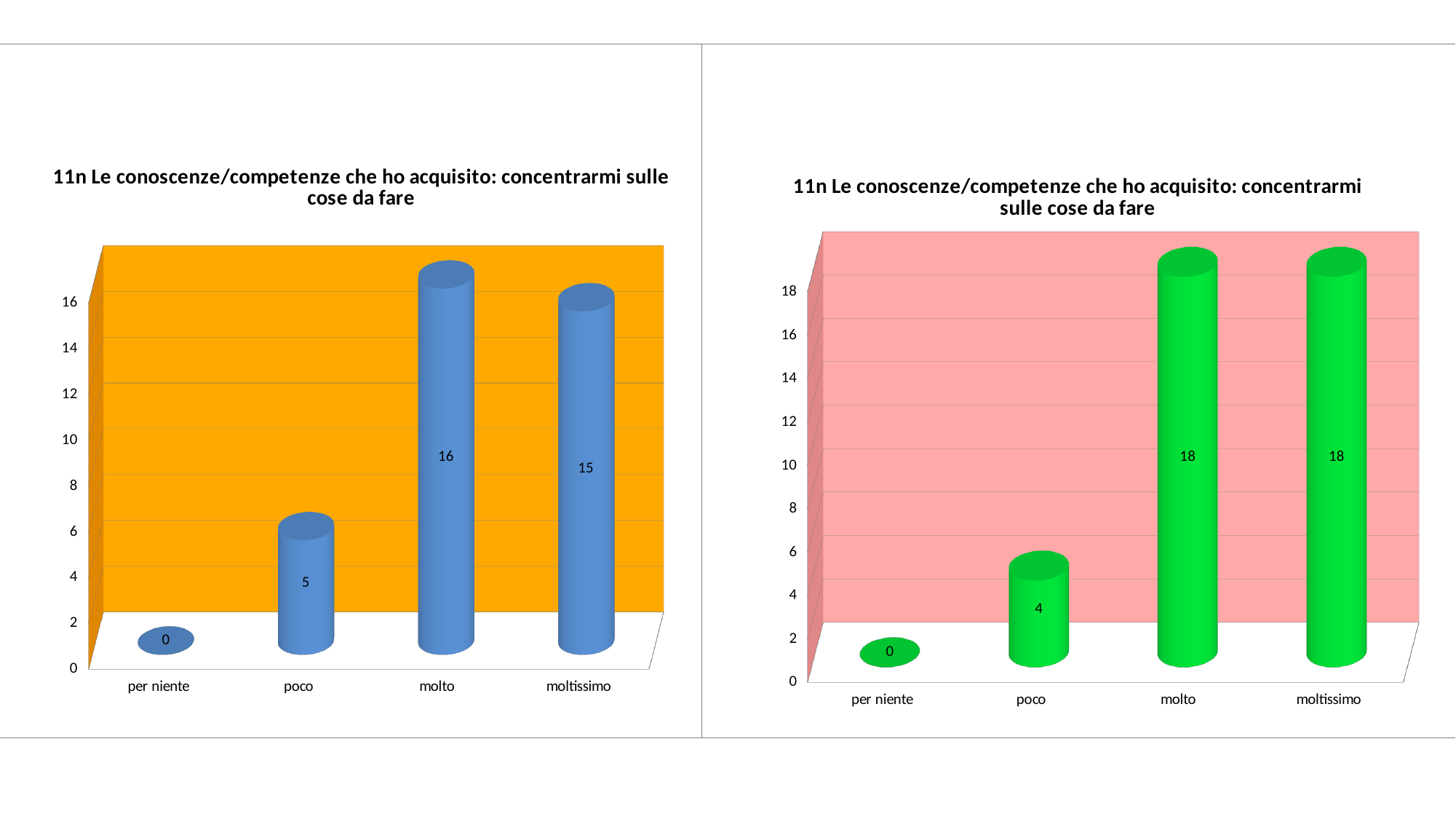
In the right chart, what is the value for 'moltissimo'? 18 How many categories are shown on the x axis of the right chart? 4 What kind of chart is the left chart? bar chart In the left chart, which is larger: the value for 'poco' or the value for 'moltissimo'? moltissimo In the left chart, what is the value for 'poco'? 5 What colour are the bars in the right chart? green In the left chart, what is the difference between the values for 'molto' and 'moltissimo'? 1 In the left chart, what is the value for 'molto'? 16 In the right chart, what is the difference between the values for 'molto' and 'poco'? 14 In the left chart, which category has the highest value? molto In the right chart, what is the value for 'poco'? 4 In the left chart, which category has the lowest value? per niente